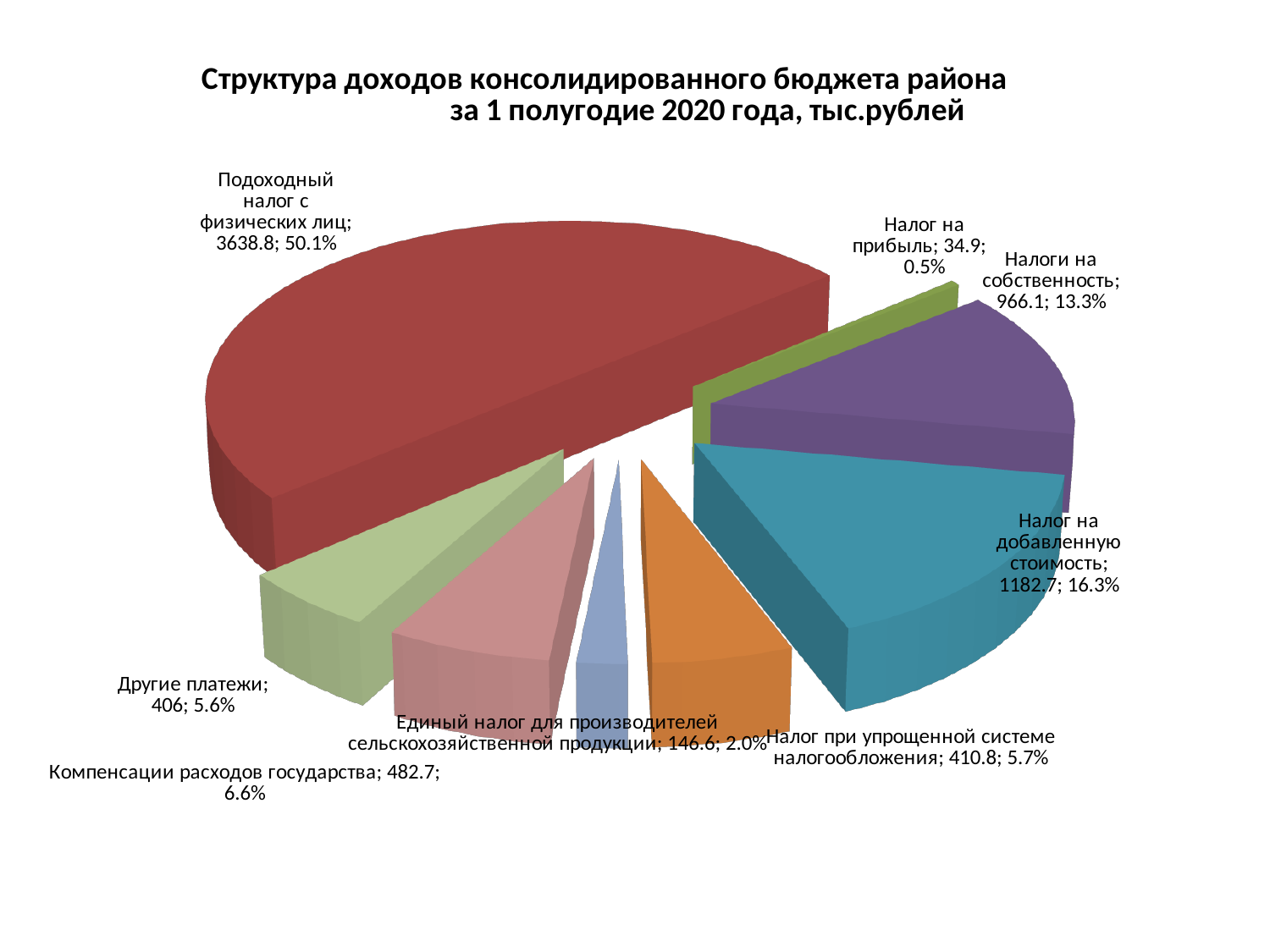
Which category has the largest slice of the pie? Подоходный налог с физических лиц Which is larger: the value for Налог при упрощенной системе налогообложения or the value for Другие платежи? Налог при упрощенной системе налогообложения How many slices does the pie chart have? 8 What type of chart is shown on the slide? Pie chart What share of the pie does Компенсации расходов государства represent? 6.6% Which category has the smallest slice of the pie? Налог на прибыль What is the value for Налог на добавленную стоимость? 1182.7 What is the value for Налоги на собственность? 966.1 What is the value for Подоходный налог с физических лиц? 3638.8 What is the title of the chart? Структура доходов консолидированного бюджета района за 1 полугодие 2020 года, тыс.рублей What is the difference between the values for Налог на добавленную стоимость and Налоги на собственность? 216.6 What share of the pie does Налог на прибыль represent? 0.5%